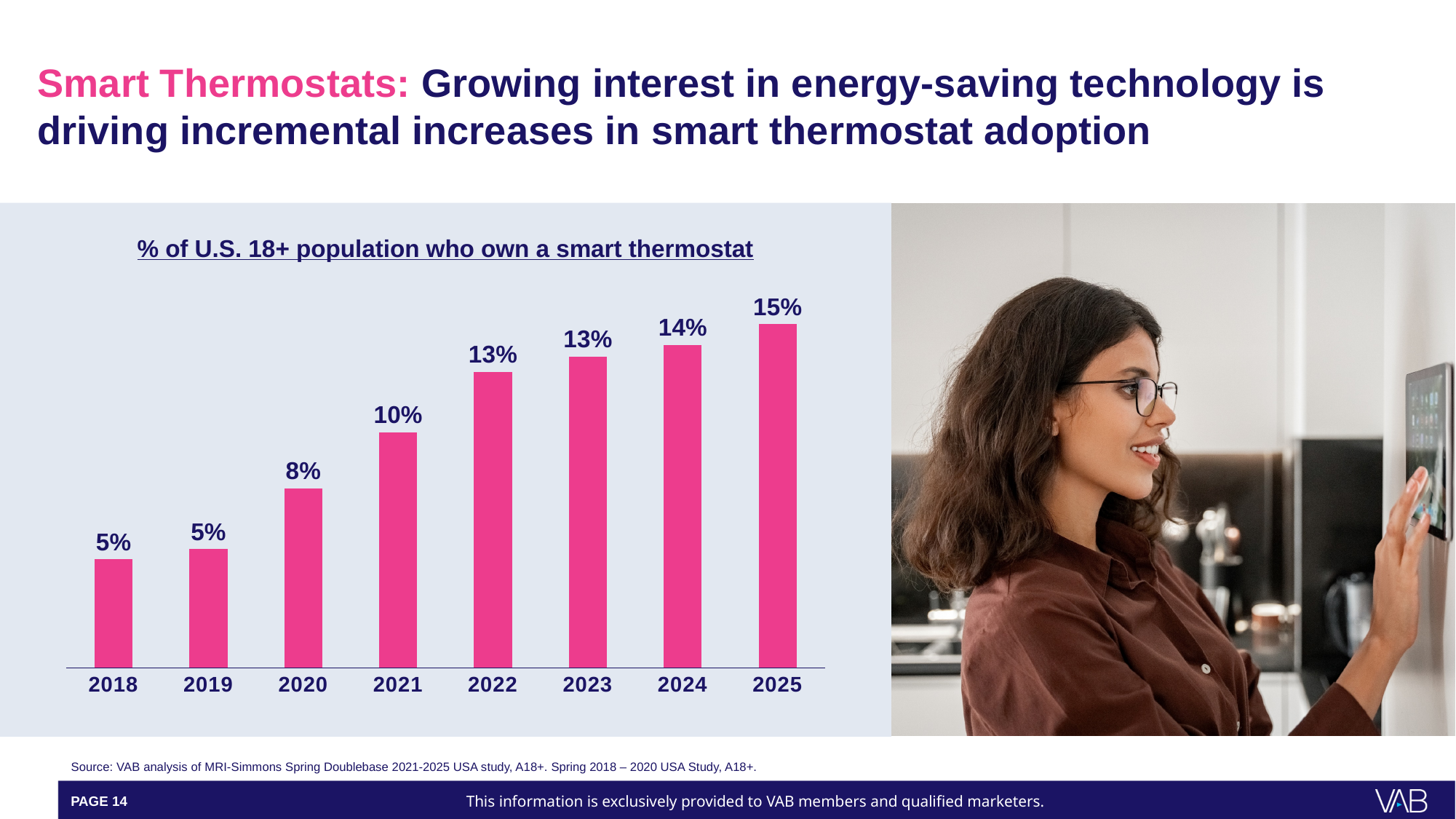
How many years are shown on the x axis of the chart? 8 What colour are the bars in the chart? Pink Which is larger, the value for 2024 or the value for 2021? 2024 What percentage of the U.S. 18+ population owned a smart thermostat in 2021? 10% What is the difference between the 2025 value and the 2018 value? 10% What kind of chart is shown on the slide? Bar chart What is the difference between the 2022 value and the 2020 value? 5% Which year has the highest percentage of smart thermostat ownership? 2025 What is the value shown for 2018? 5% Do the values generally rise or fall from 2018 to 2025? Rise What is the title of the chart? % of U.S. 18+ population who own a smart thermostat What is the value shown for 2025? 15%